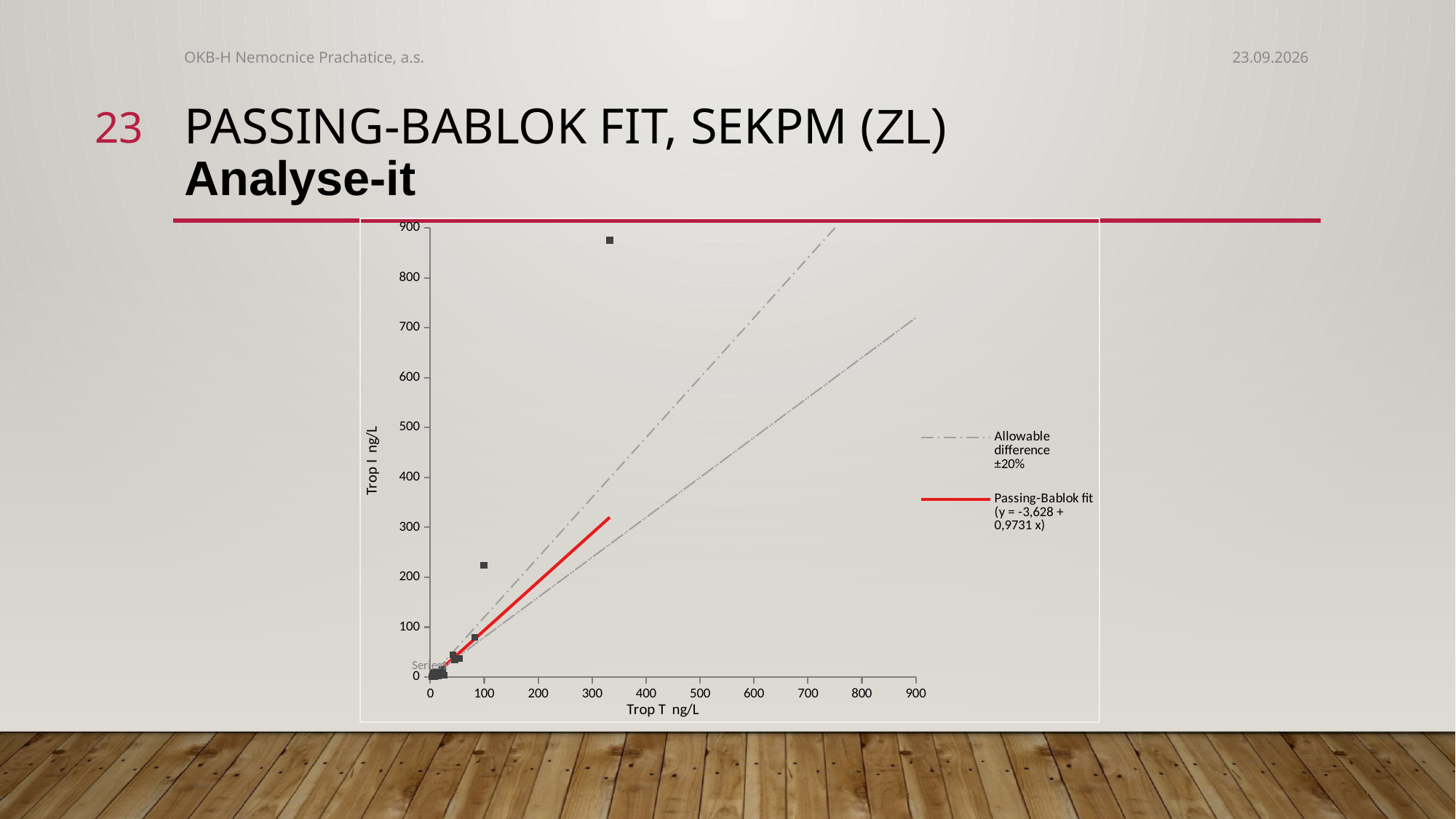
What is the label of the y axis? Trop I ng/L What allowable difference is shown by the dash-dot lines according to the legend? ±20% Is the Trop I value of the point plotted at about 100 ng/L Trop T greater or less than 200? greater Is the Trop I value of the highest plotted point greater or less than 800? greater Does the Passing-Bablok fit line rise or fall as Trop T increases? rise What is the highest value shown on the x axis? 900 What is the label of the x axis? Trop T ng/L What equation does the legend give for the Passing-Bablok fit? y = -3,628 + 0,9731 x Is the Trop T value of the highest plotted point greater or less than 400? less What kind of chart is shown on the slide? scatter chart What is the slope of the Passing-Bablok fit given in the legend? 0,9731 What is the highest value shown on the y axis? 900